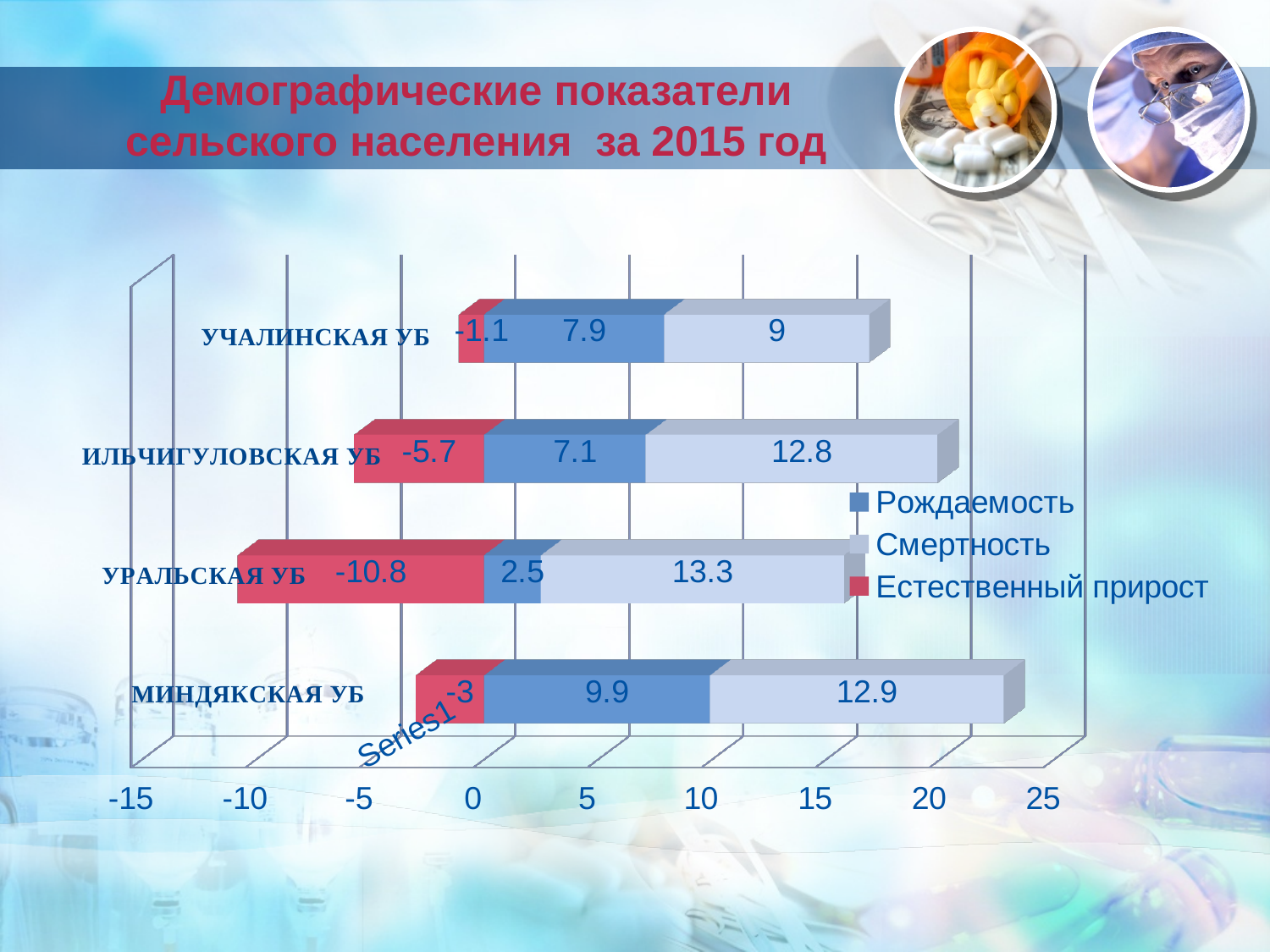
Which category has the lowest Естественный прирост value? УРАЛЬСКАЯ УБ How many series does the legend list? 3 What is the difference between the Смертность and Рождаемость values for УРАЛЬСКАЯ УБ? 10.8 What is the Смертность value for УРАЛЬСКАЯ УБ? 13.3 What kind of chart is shown on the slide? Stacked bar chart Which category has the highest Рождаемость value? МИНДЯКСКАЯ УБ What is the Естественный прирост value for ИЛЬЧИГУЛОВСКАЯ УБ? -5.7 Which is larger, the Рождаемость value for ИЛЬЧИГУЛОВСКАЯ УБ or for УЧАЛИНСКАЯ УБ? УЧАЛИНСКАЯ УБ What is the Рождаемость value for УЧАЛИНСКАЯ УБ? 7.9 How many categories are shown in the chart? 4 Which category has the lowest Смертность value? УЧАЛИНСКАЯ УБ What is the Смертность value for МИНДЯКСКАЯ УБ? 12.9